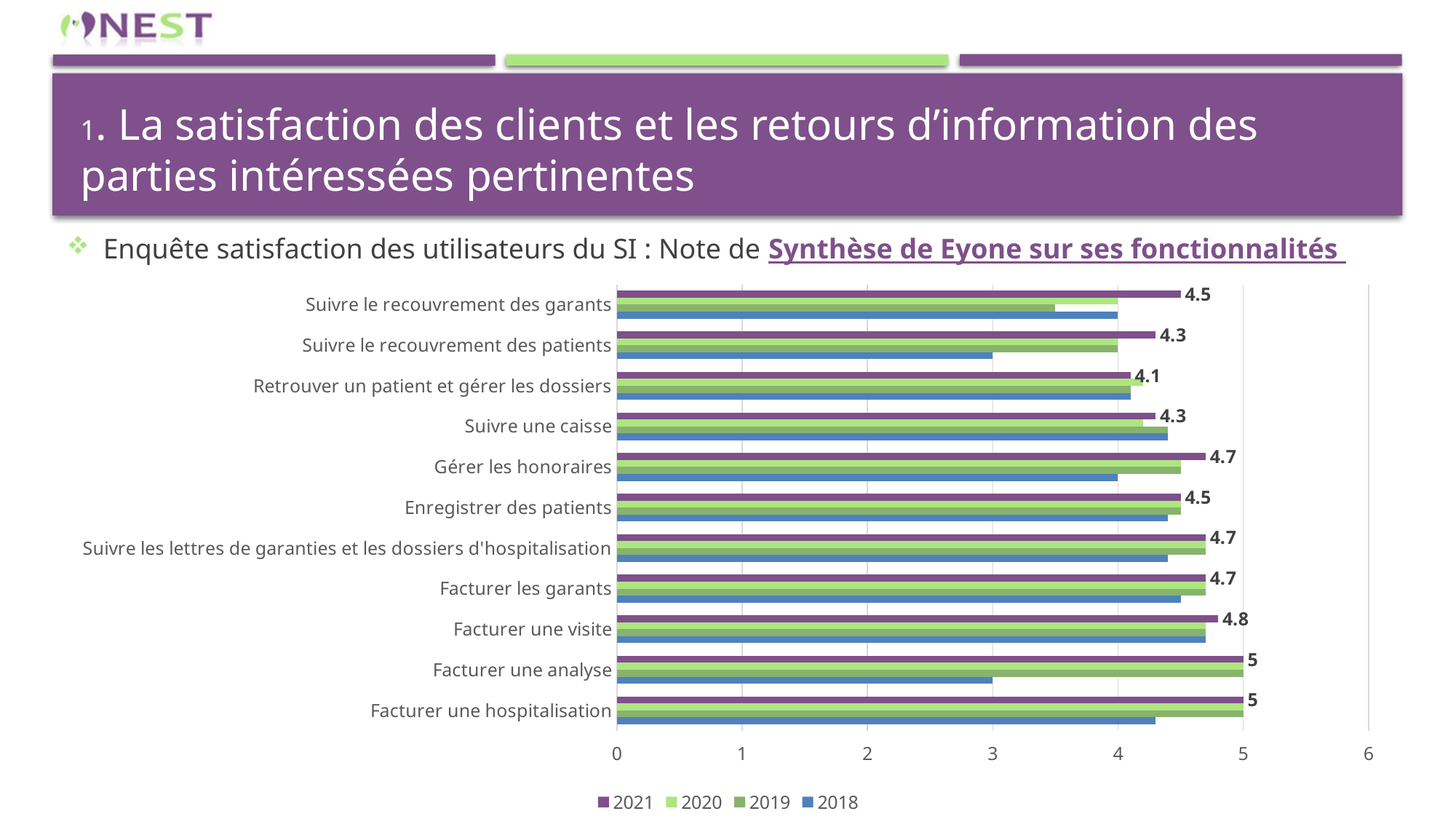
Which series is shown in purple in the legend? 2021 Which is larger for 2021: 'Facturer une analyse' or 'Suivre le recouvrement des patients'? Facturer une analyse What is the 2021 value for 'Gérer les honoraires'? 4.7 How many categories are plotted on the chart? 11 How many series does the legend list? 4 Is the 2019 value for 'Suivre le recouvrement des garants' greater or less than 4? less What kind of chart is shown on the slide? bar chart Which category has the lowest 2021 value? Retrouver un patient et gérer les dossiers What is the 2021 value for 'Facturer une visite'? 4.8 Is the 2018 value for 'Facturer une analyse' greater or less than 4? less What is the difference between the 2021 values for 'Facturer une visite' and 'Retrouver un patient et gérer les dossiers'? 0.7 What is the 2021 value for 'Retrouver un patient et gérer les dossiers'? 4.1